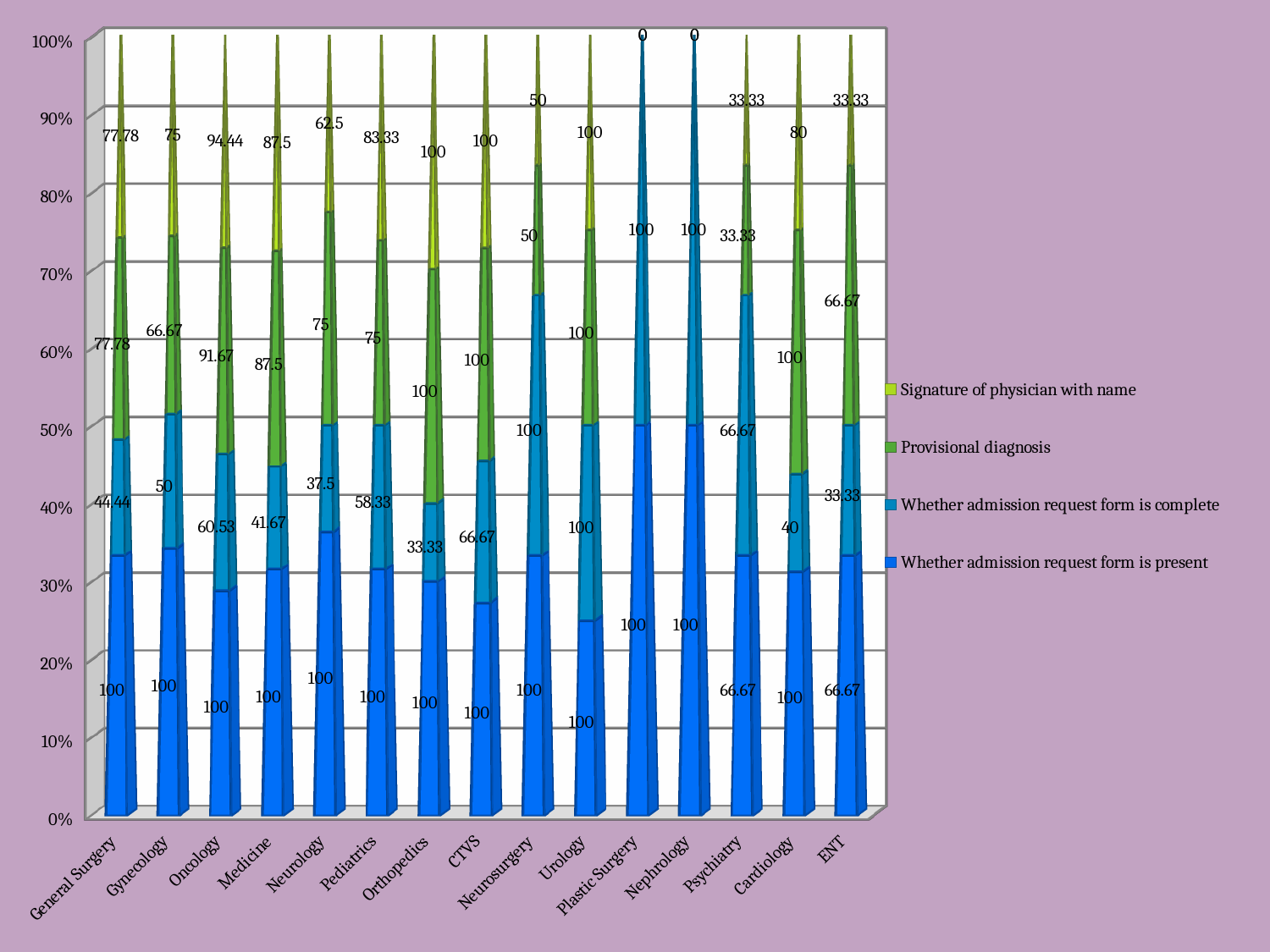
What is the value for 'Provisional diagnosis' for Plastic Surgery? 0 What is the value for 'Whether admission request form is complete' for Oncology? 60.53 Which department has the lowest 'Whether admission request form is complete' value? Orthopedics and ENT (tied at 33.33) Which is larger: the 'Signature of physician with name' value for Oncology or for Gynecology? Oncology What is the value for 'Provisional diagnosis' for Cardiology? 100 Which legend entry is shown in green? Provisional diagnosis What is the value for 'Signature of physician with name' for Neurology? 62.5 What kind of chart is shown on the slide? Stacked bar chart How many categories (departments) are shown on the x axis of the chart? 15 What is the value for 'Whether admission request form is present' for Psychiatry? 66.67 How many series does the chart's legend list? 4 What is the difference between the 'Whether admission request form is complete' values for CTVS and Orthopedics? 33.34